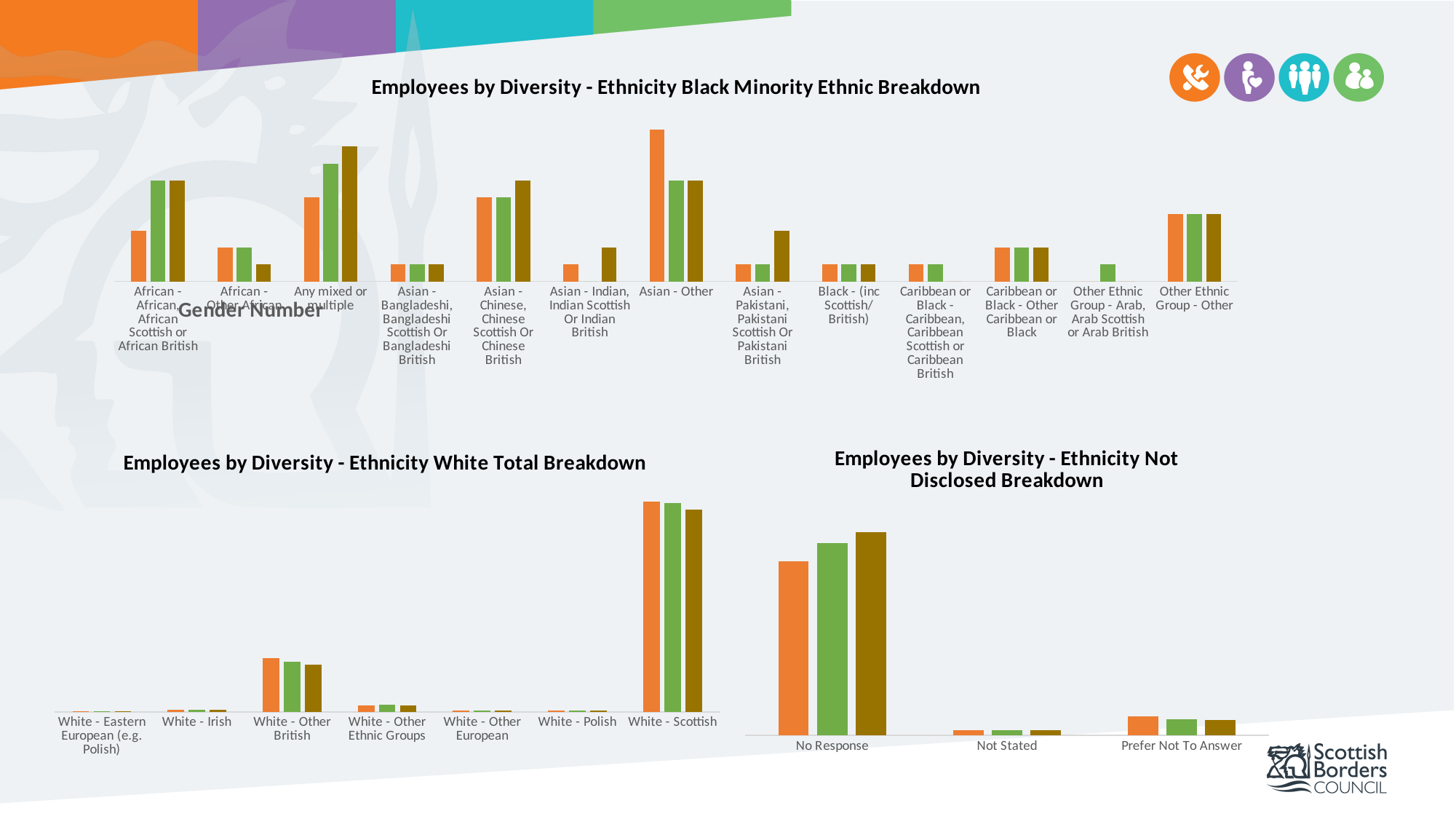
What is the title of the chart at the top of the slide? Employees by Diversity - Ethnicity Black Minority Ethnic Breakdown In the 'Employees by Diversity - Ethnicity Not Disclosed Breakdown' chart, how many bars are shown for the No Response category? 3 In the 'Employees by Diversity - Ethnicity Black Minority Ethnic Breakdown' chart, which category contains the single tallest bar? Asian - Other In the 'Employees by Diversity - Ethnicity Black Minority Ethnic Breakdown' chart, how many categories are shown on the x axis? 13 What type of chart is the 'Employees by Diversity - Ethnicity White Total Breakdown' chart? bar chart In the 'Employees by Diversity - Ethnicity White Total Breakdown' chart, which category has the highest bars? White - Scottish In the 'Employees by Diversity - Ethnicity White Total Breakdown' chart, how many categories are shown on the x axis? 7 In the 'Employees by Diversity - Ethnicity Not Disclosed Breakdown' chart, which category has the highest bars? No Response In the 'Employees by Diversity - Ethnicity White Total Breakdown' chart, which category has larger bars: White - Other British or White - Other Ethnic Groups? White - Other British In the 'Employees by Diversity - Ethnicity Not Disclosed Breakdown' chart, which category has larger bars: No Response or Prefer Not To Answer? No Response In the 'Employees by Diversity - Ethnicity Not Disclosed Breakdown' chart, which category has the lowest bars? Not Stated